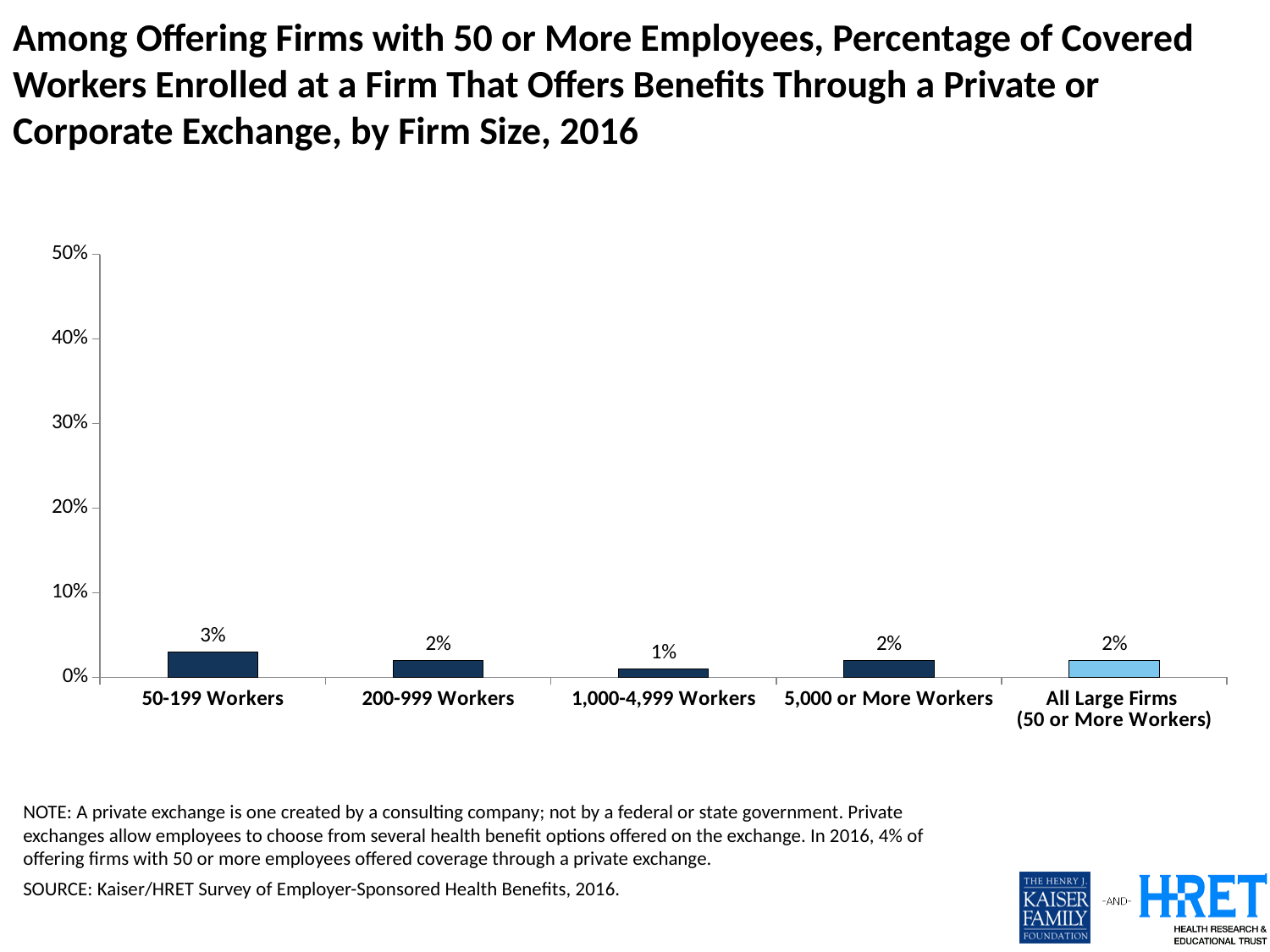
Which is larger, the value for 50-199 Workers or the value for 200-999 Workers? 50-199 Workers How many firm size categories are shown on the chart? 5 What is the value for 1,000-4,999 Workers? 1% Is the value for 50-199 Workers greater or less than 10%? less What kind of chart is shown on the slide? bar chart Which firm size category has the highest value? 50-199 Workers What is the value for 50-199 Workers? 3% What is the value for 5,000 or More Workers? 2% What is the highest value shown on the vertical axis? 50% What is the value for All Large Firms (50 or More Workers)? 2% What is the difference between the values for 50-199 Workers and 1,000-4,999 Workers? 2% Which firm size category has the lowest value? 1,000-4,999 Workers